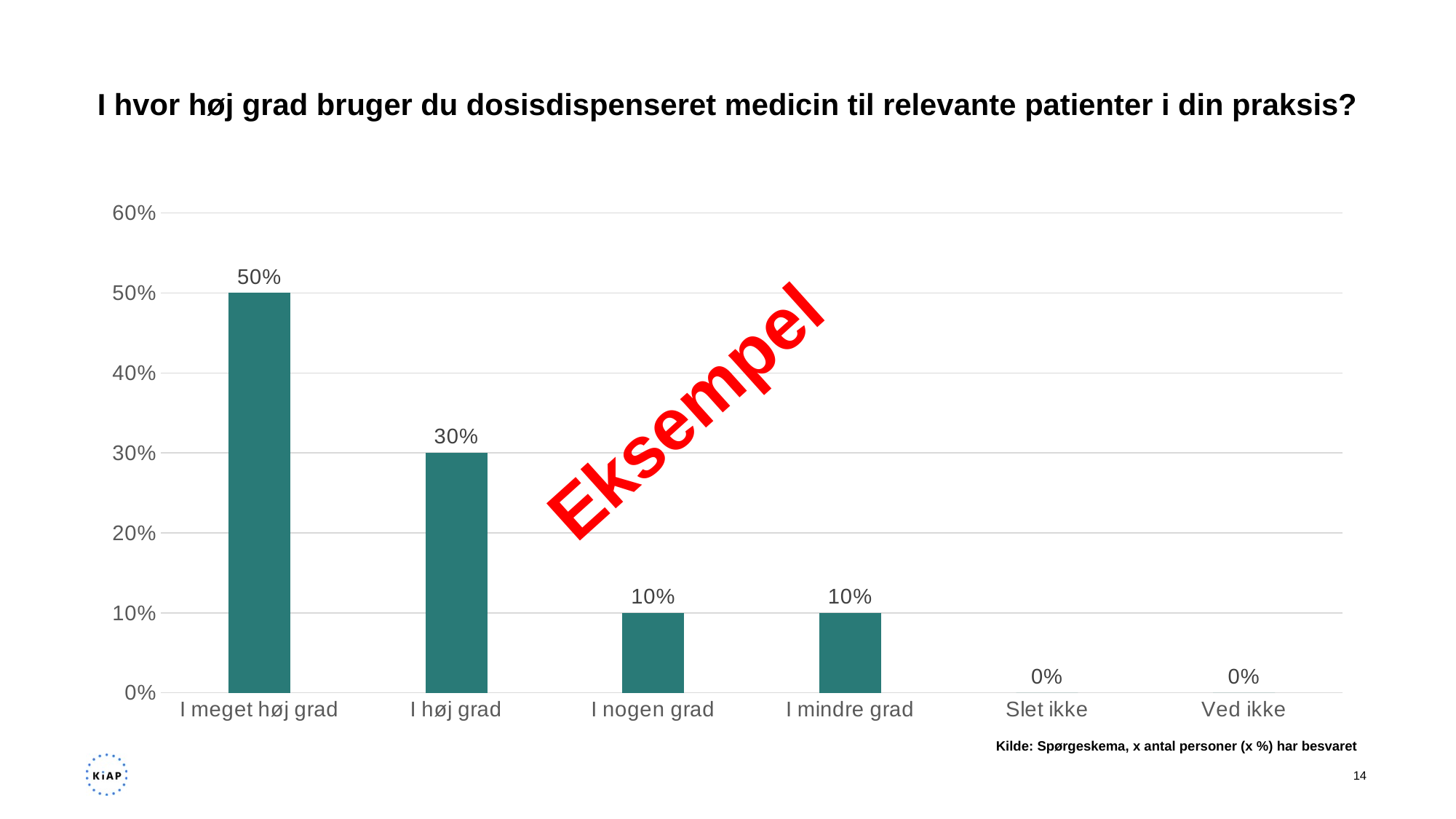
What is the title of the chart? I hvor høj grad bruger du dosisdispenseret medicin til relevante patienter i din praksis? What is the value for "I høj grad"? 30% What is the difference between the values for "I meget høj grad" and "I høj grad"? 20% How many categories are shown on the x axis? 6 Which is larger, the value for "I høj grad" or the value for "I mindre grad"? I høj grad What kind of chart is shown on the slide? bar chart Do the values rise or fall from left to right along the x axis? fall Which category has the highest value? I meget høj grad What is the value for "I nogen grad"? 10% Is the value for "I meget høj grad" greater or less than 40%? greater What is the value for "Slet ikke"? 0% What is the value for "I meget høj grad"? 50%